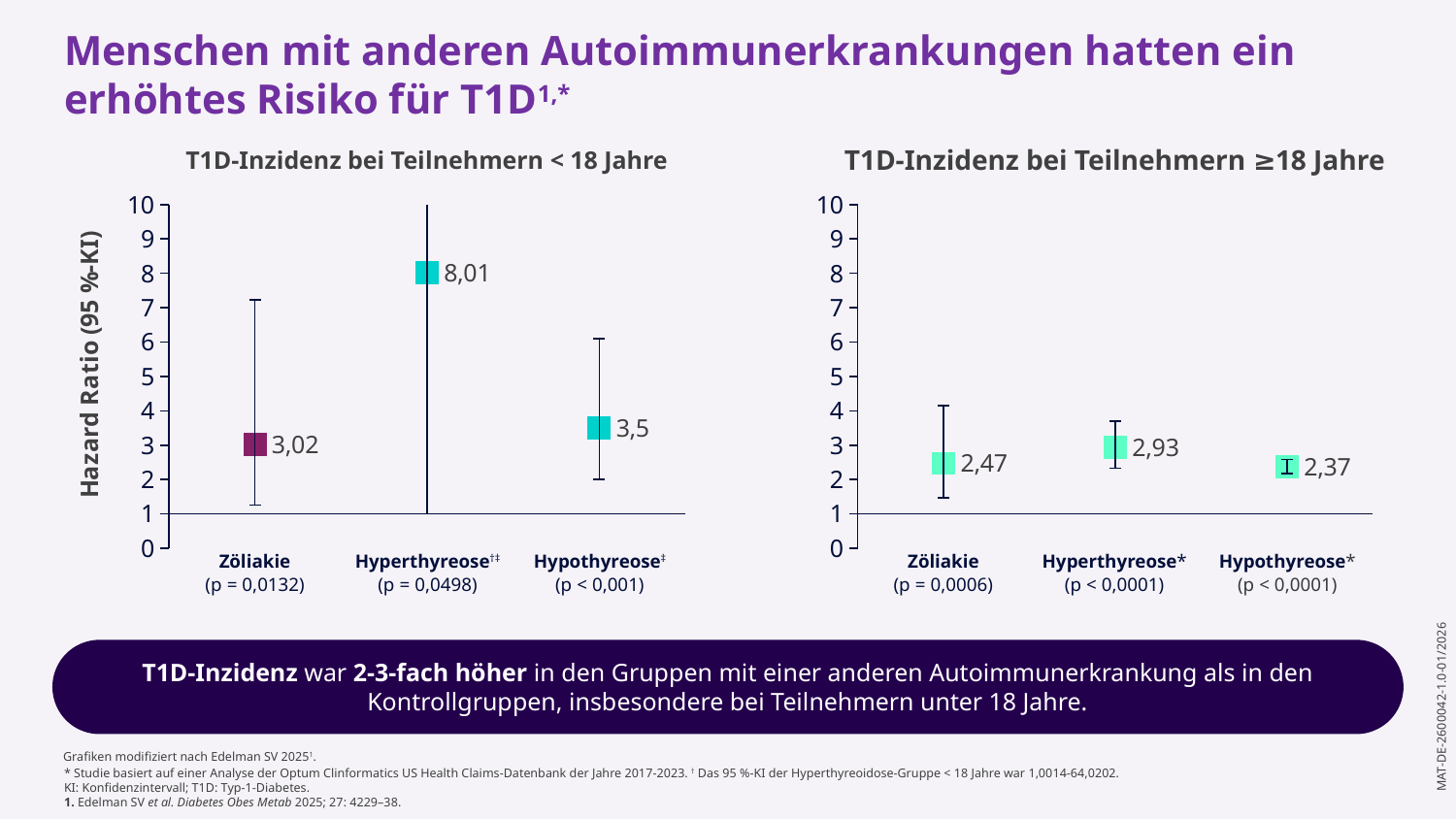
In the chart 'T1D-Inzidenz bei Teilnehmern < 18 Jahre', what is the difference between the hazard ratios for Hyperthyreose and Zöliakie? 4,99 What is the label of the y-axis on the left chart? Hazard Ratio (95 %-KI) How many groups are plotted in the chart 'T1D-Inzidenz bei Teilnehmern ≥18 Jahre'? 3 In the chart 'T1D-Inzidenz bei Teilnehmern < 18 Jahre', which group has the highest hazard ratio? Hyperthyreose In the chart 'T1D-Inzidenz bei Teilnehmern < 18 Jahre', is the hazard ratio for Hypothyreose greater or less than 3? greater In the chart 'T1D-Inzidenz bei Teilnehmern < 18 Jahre', what is the hazard ratio for Hyperthyreose? 8,01 In the chart 'T1D-Inzidenz bei Teilnehmern ≥18 Jahre', what is the hazard ratio for Hyperthyreose? 2,93 Which is larger: the hazard ratio for Zöliakie in the '< 18 Jahre' chart or in the '≥18 Jahre' chart? < 18 Jahre In the chart 'T1D-Inzidenz bei Teilnehmern ≥18 Jahre', what is the difference between the hazard ratios for Hyperthyreose and Zöliakie? 0,46 In the chart 'T1D-Inzidenz bei Teilnehmern ≥18 Jahre', what is the hazard ratio for Hypothyreose? 2,37 In the chart 'T1D-Inzidenz bei Teilnehmern ≥18 Jahre', which group has the lowest hazard ratio? Hypothyreose In the chart 'T1D-Inzidenz bei Teilnehmern < 18 Jahre', what is the hazard ratio for Zöliakie? 3,02